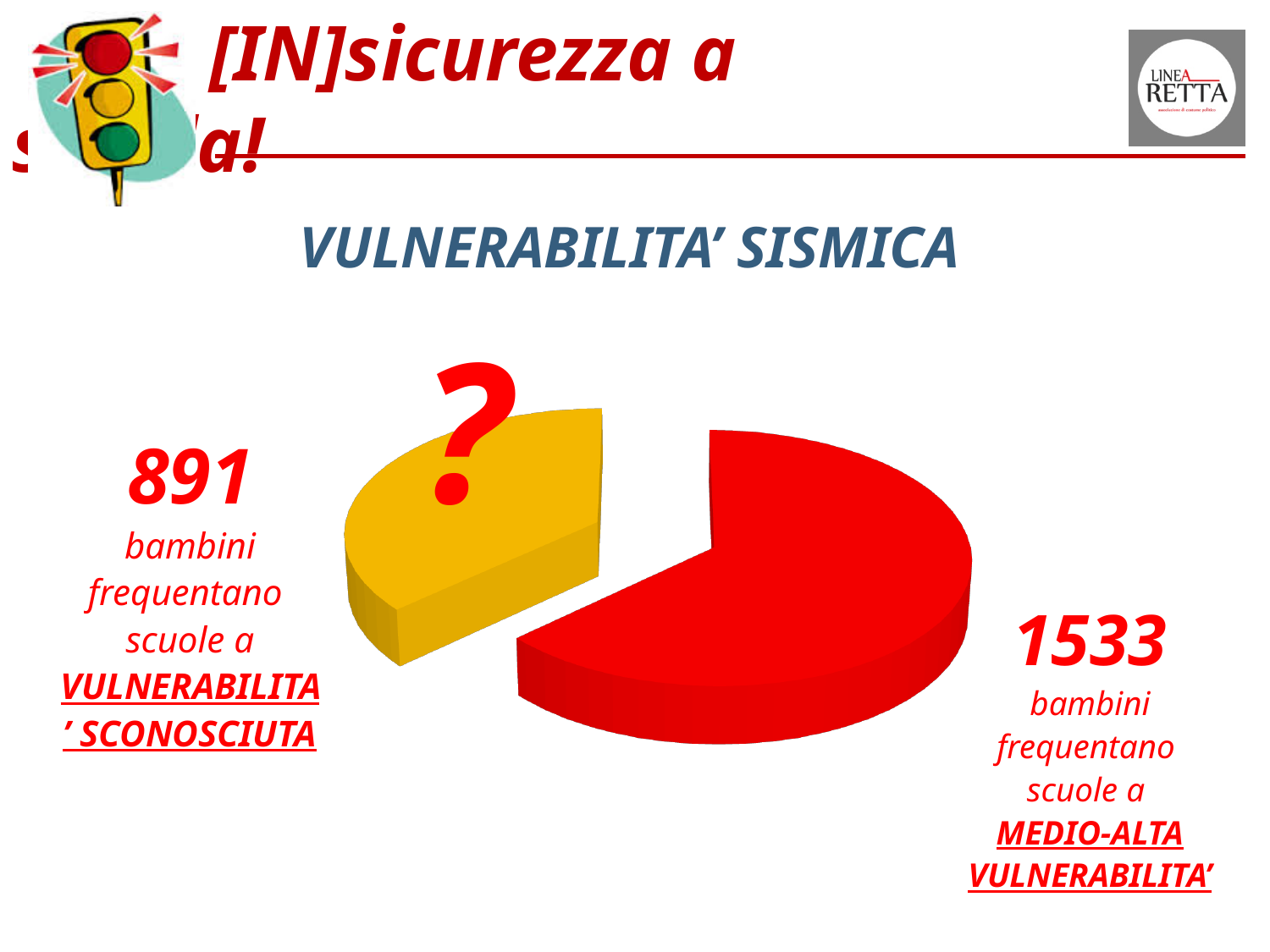
What is the total number of children represented by the two slices of the pie chart? 2424 Which category has the smallest slice of the pie chart? vulnerabilità sconosciuta Which category has the largest slice of the pie chart? medio-alta vulnerabilità What is the title above the pie chart? VULNERABILITA' SISMICA How many children attend schools with medio-alta vulnerabilità according to the chart? 1533 How many slices does the pie chart have? 2 What is the difference between the number of children in schools with medio-alta vulnerabilità and those with vulnerabilità sconosciuta? 642 Which is larger: the number of children in schools with medio-alta vulnerabilità or with vulnerabilità sconosciuta? medio-alta vulnerabilità How many children does the yellow slice of the pie chart represent? 891 What colour is the slice representing schools with medio-alta vulnerabilità? red What kind of chart is shown on the slide? pie chart How many children attend schools with vulnerabilità sconosciuta according to the chart? 891